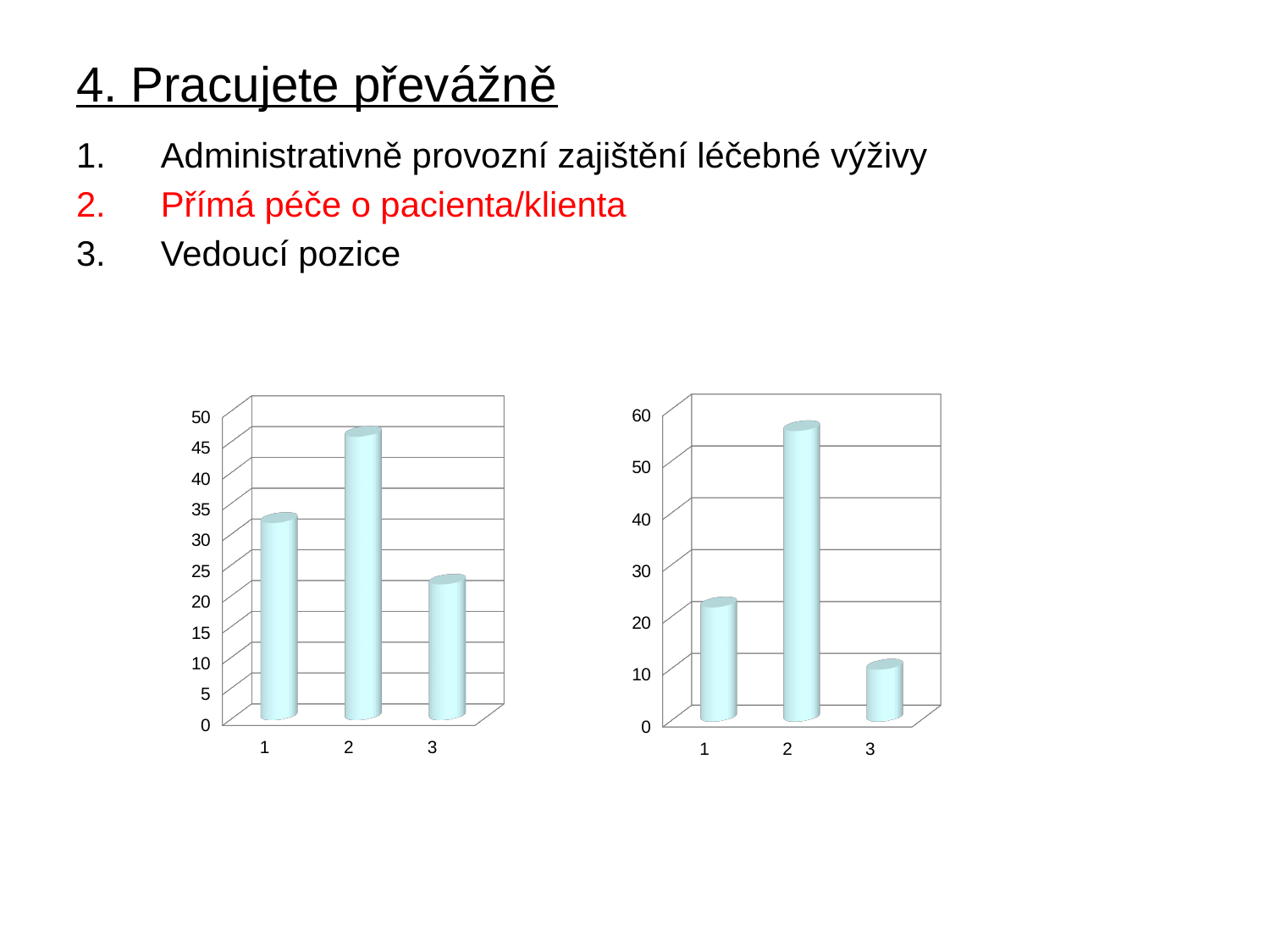
In the left chart, which category has the lowest bar? 3 In the left chart, is the value for category 3 greater or less than 30? less In the right chart, is the value for category 3 greater or less than 20? less In the left chart, is the value for category 1 greater or less than 25? greater How many categories are shown on the x axis of the right chart? 3 In the right chart, which category has the highest bar? 2 What kind of chart is the left chart? bar chart In the left chart, which is larger, the value for category 1 or category 3? category 1 In the right chart, which category has the lowest bar? 3 In the left chart, which category has the highest bar? 2